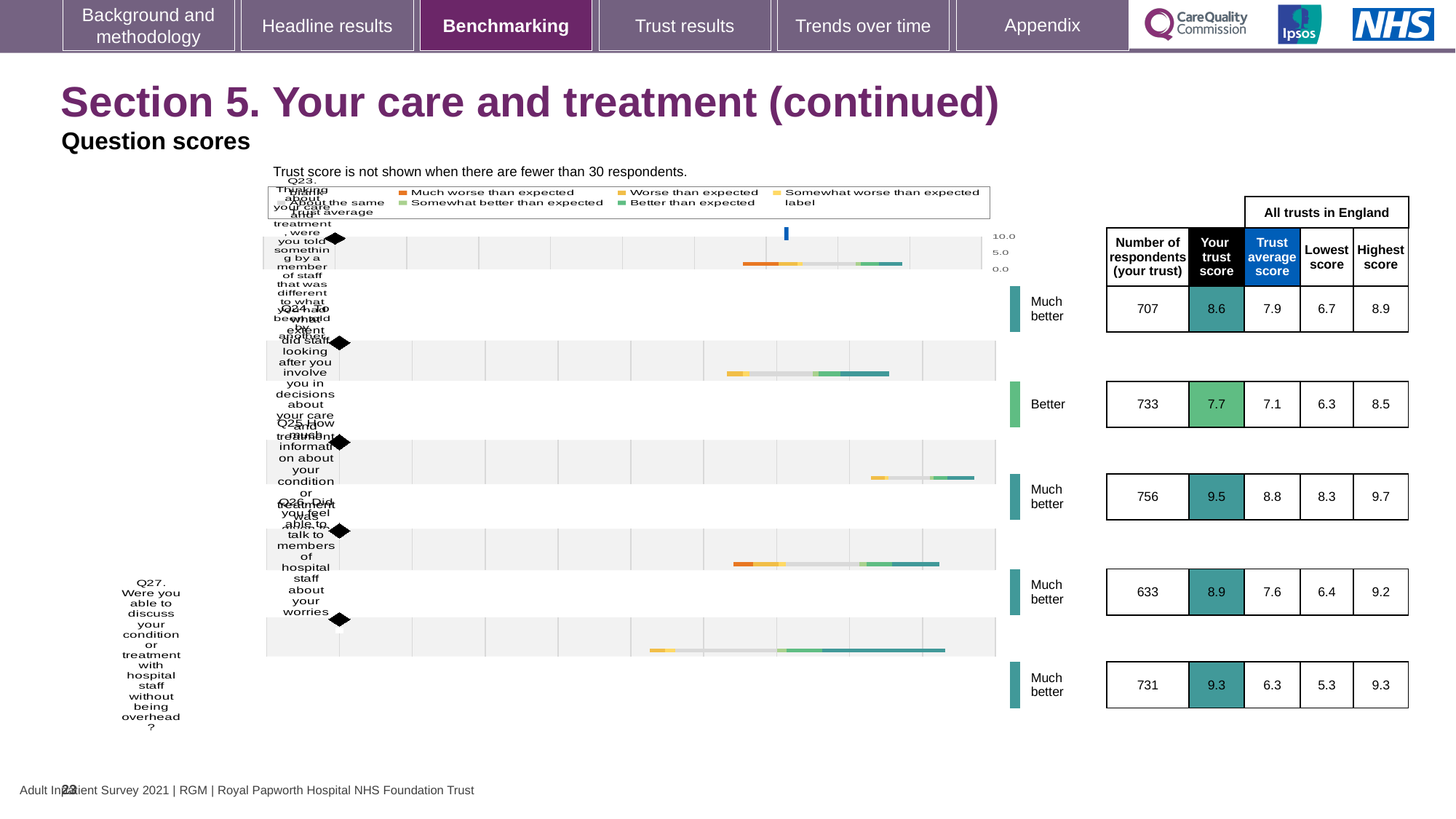
How many respondents (your trust) are shown for Q23? 707 What is the 'Highest score' across all trusts in England for Q25? 9.7 What kind of chart is used to show the question scores on this slide? Bar chart What benchmark label is shown next to the bar for Q24? Better What is the difference between the 'Your trust score' and the 'Trust average score' for Q27? 3.0 By how much does the 'Your trust score' for Q23 exceed the 'Trust average score' for Q23? 0.7 What is the 'Trust average score' for Q26? 7.6 How many questions (Q23 to Q27) are plotted on the chart? 5 Which has the higher 'Your trust score', Q26 or Q24? Q26 Which question has the lowest 'Your trust score'? Q24 Which question has the highest 'Your trust score'? Q25 What is the 'Your trust score' for Q25? 9.5